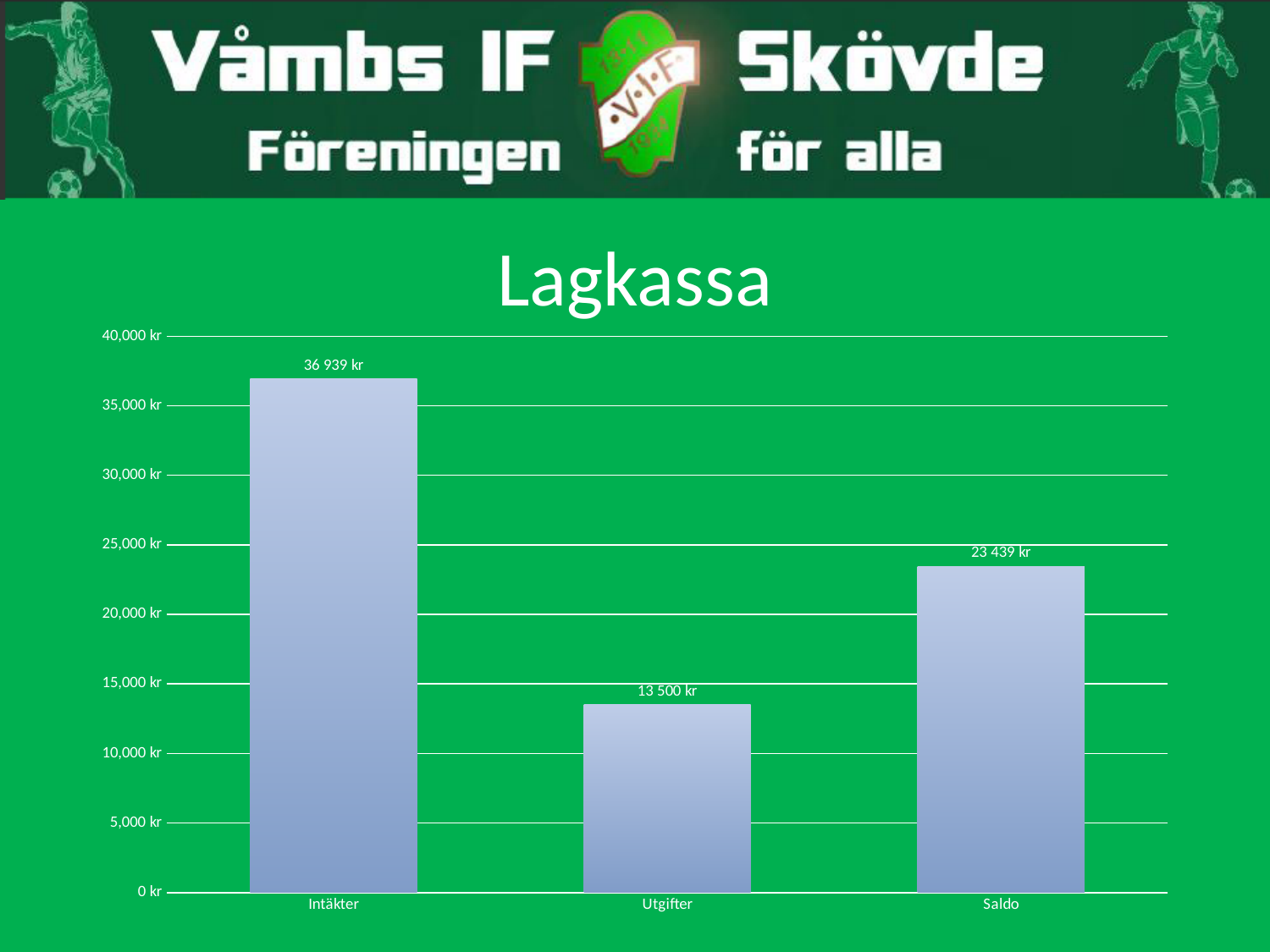
How many categories are shown on the x axis? 3 What is the difference between Saldo and Utgifter? 9 939 kr What is the value for Utgifter? 13 500 kr What is the value for Saldo? 23 439 kr Which category has the lowest value? Utgifter What kind of chart is shown? bar chart Which category has the highest value? Intäkter Is the value for Saldo greater or less than 25,000 kr? less What is the difference between Intäkter and Utgifter? 23 439 kr What is the value for Intäkter? 36 939 kr What is the title of the chart? Lagkassa Which is larger, Saldo or Utgifter? Saldo